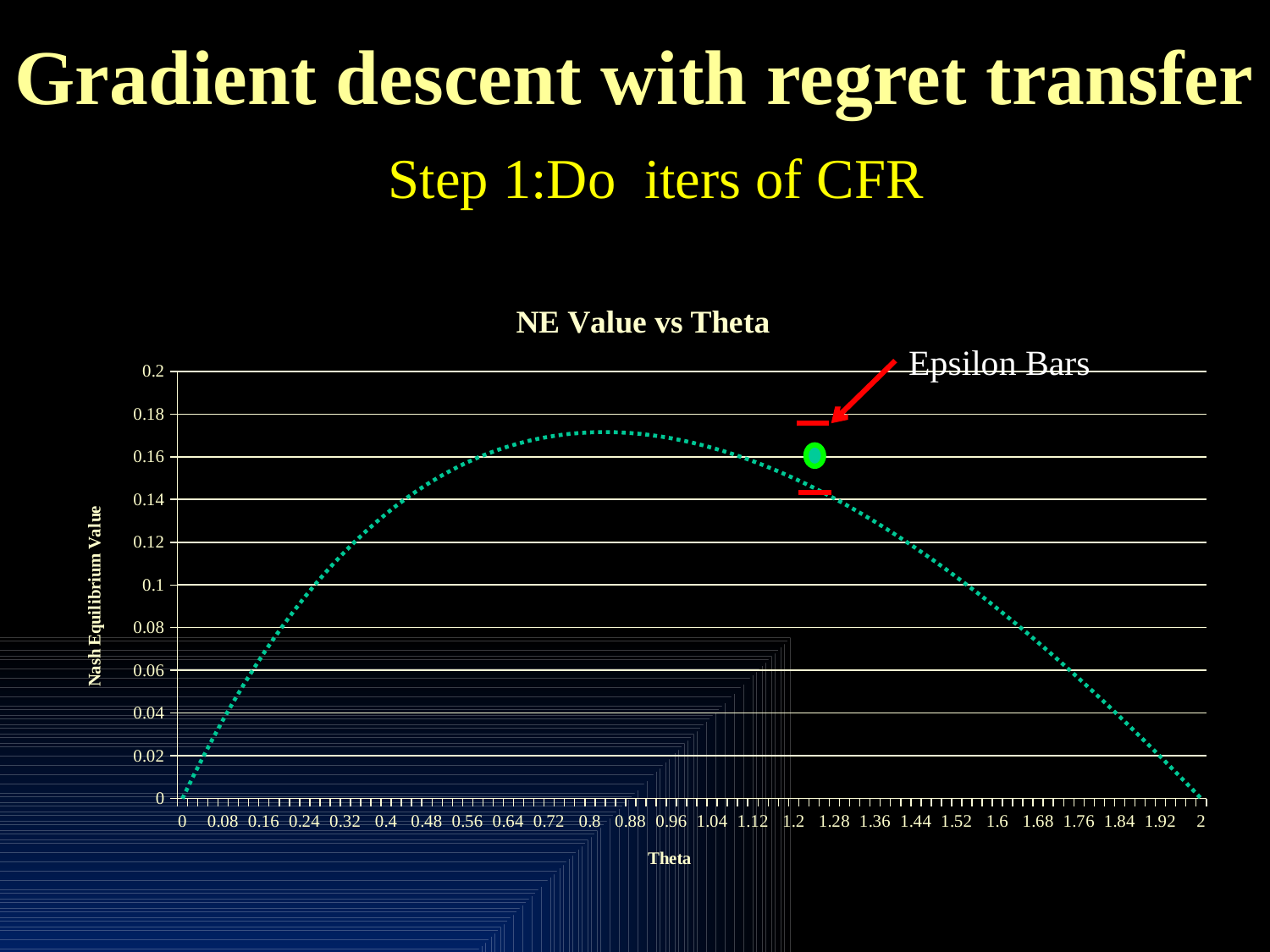
What is the Nash Equilibrium Value at Theta = 2? 0 What is the Nash Equilibrium Value at Theta = 0? 0 How does the Nash Equilibrium Value change as Theta increases from 0 to 2? It rises to a peak and then falls Is the Nash Equilibrium Value at Theta = 1.6 greater or less than 0.12? less Is the Nash Equilibrium Value at Theta = 1.2 greater or less than 0.14? greater What type of chart is shown on the slide? line chart What is the title of the chart? NE Value vs Theta Is the Nash Equilibrium Value at Theta = 0.8 greater or less than 0.16? greater Which has the larger Nash Equilibrium Value, Theta = 0.4 or Theta = 1.6? Theta = 0.4 What is the label of the y axis of the chart? Nash Equilibrium Value Which has the larger Nash Equilibrium Value, Theta = 0.8 or Theta = 1.76? Theta = 0.8